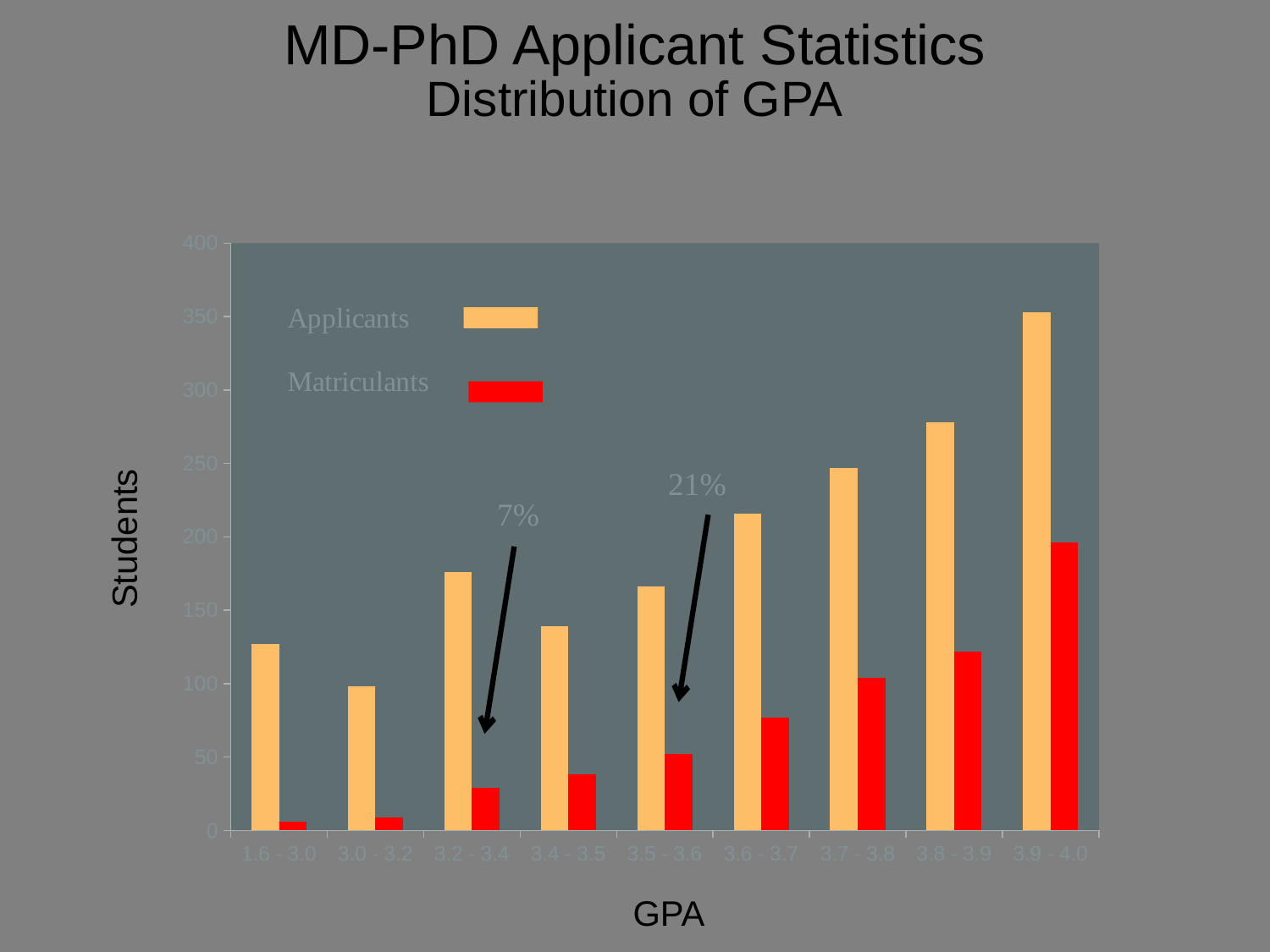
Which GPA range has the highest number of Matriculants? 3.9 - 4.0 What kind of chart is shown on the slide? bar chart Which GPA range has the lowest number of Applicants? 3.0 - 3.2 Which is larger: the number of Applicants in the 3.2 - 3.4 range or in the 3.4 - 3.5 range? 3.2 - 3.4 What percentage is annotated with an arrow pointing at the 3.5 - 3.6 GPA range? 21% What colour are the Matriculants bars? red Is the number of Applicants in the 3.9 - 4.0 GPA range greater or less than 300? greater How many series does the legend list? 2 Which GPA range has the highest number of Applicants? 3.9 - 4.0 Is the number of Matriculants in the 3.6 - 3.7 GPA range greater or less than 100? less Which is larger: the number of Matriculants in the 3.8 - 3.9 range or in the 3.7 - 3.8 range? 3.8 - 3.9 How many GPA categories are shown on the x axis? 9